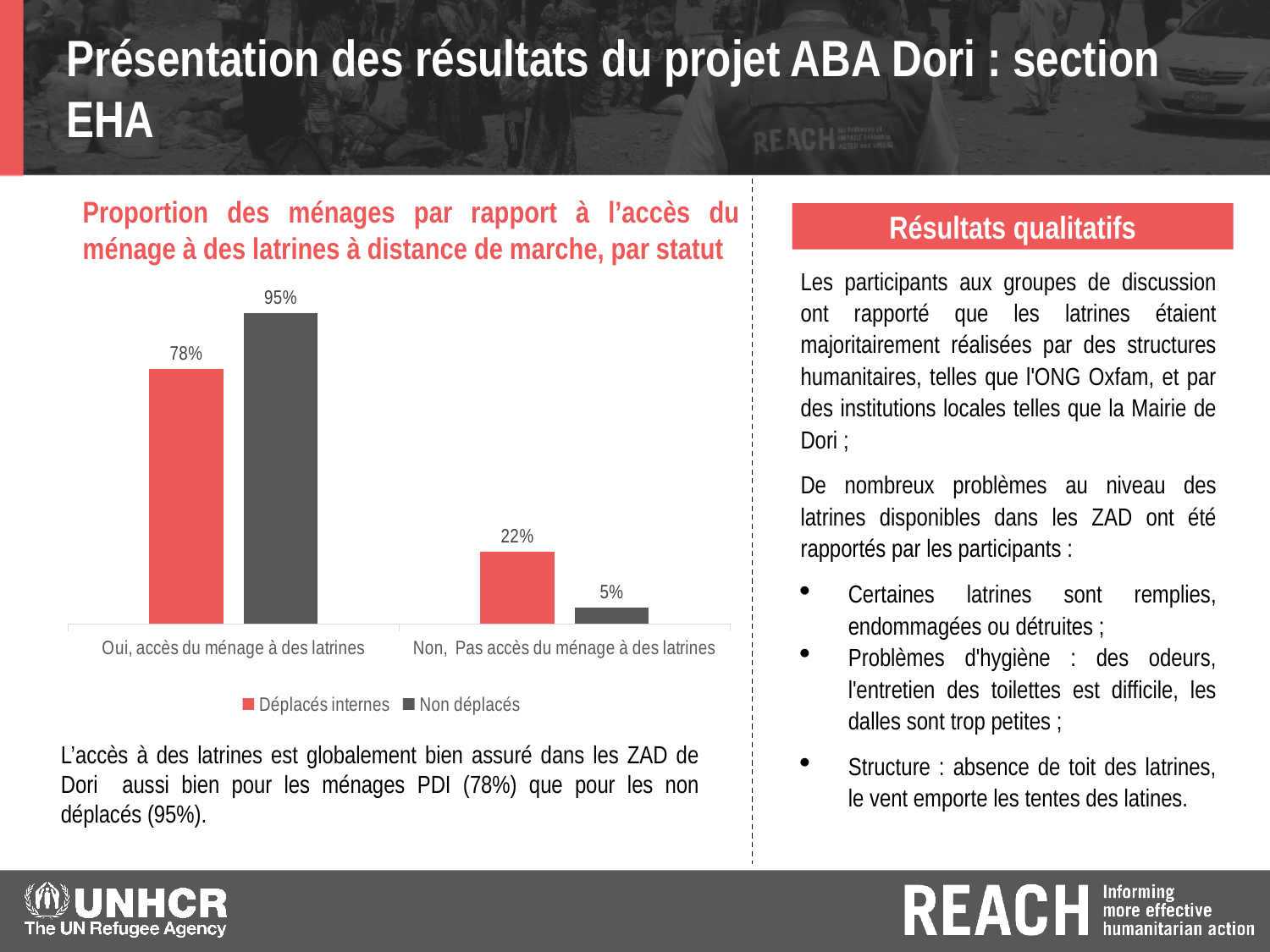
What is the difference between the Non déplacés and Déplacés internes values for the 'Oui' category? 17 percentage points What type of chart is shown on the slide? Bar chart Which series has the highest value in the chart? Non déplacés How many series does the chart legend list? 2 What percentage of internally displaced households (Déplacés internes) do not have access to latrines (Non)? 22% What percentage of internally displaced households (Déplacés internes) have access to latrines within walking distance (Oui)? 78% What percentage of non-displaced households (Non déplacés) do not have access to latrines (Non)? 5% Which colour represents the 'Déplacés internes' series in the chart? Red Which bar shows the lowest value in the chart? Non déplacés, Non (5%) How many categories are shown on the x axis of the chart? 2 For the 'Non' category, which series has the larger value: Déplacés internes or Non déplacés? Déplacés internes What percentage of non-displaced households (Non déplacés) have access to latrines within walking distance (Oui)? 95%